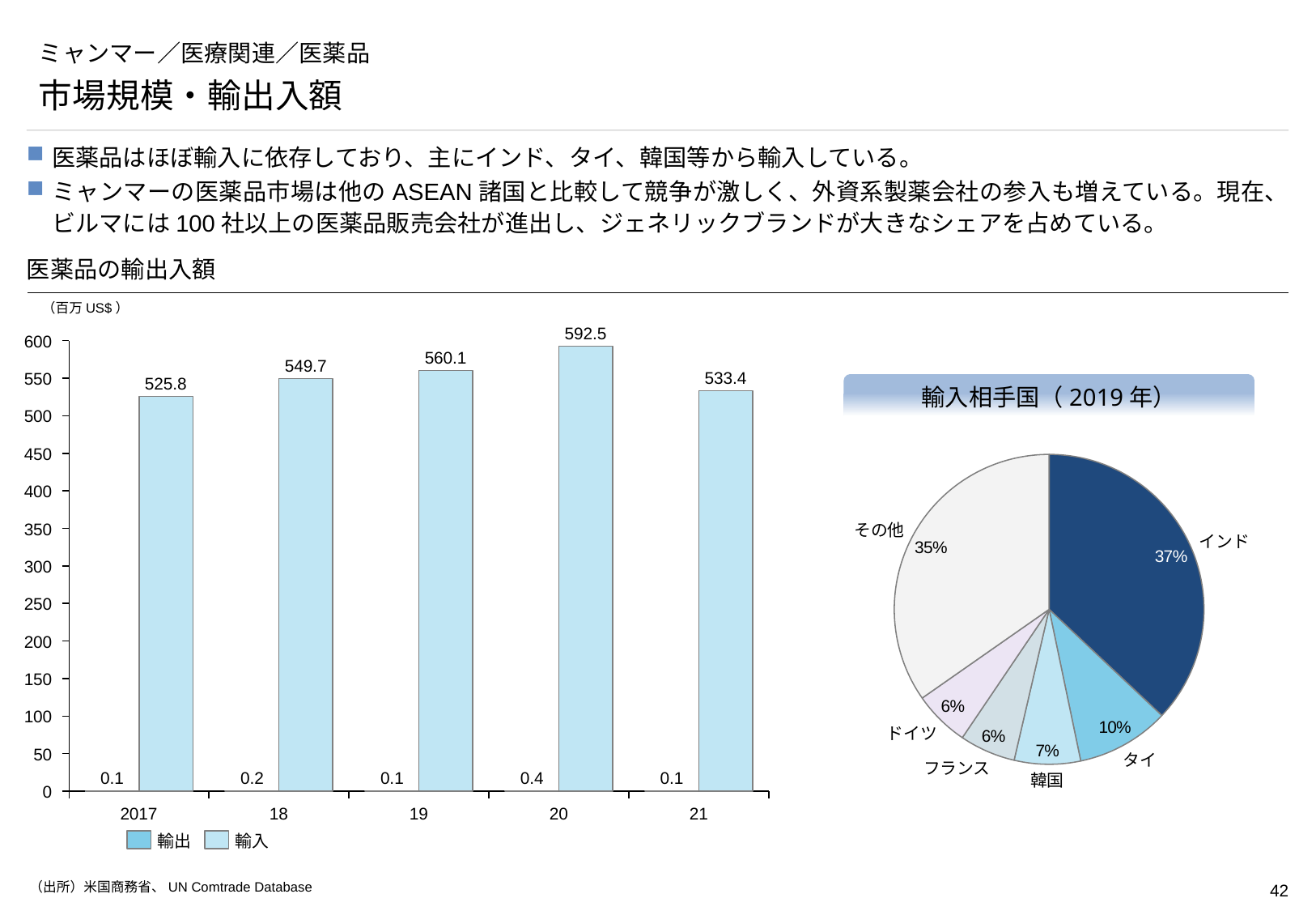
In the bar chart 医薬品の輸出入額, how many years are shown on the x axis? 5 In the bar chart 医薬品の輸出入額, is the 輸入 value for 2018 larger than the 輸入 value for 2019? No What kind of chart is 輸入相手国（2019年）? Pie chart In the bar chart 医薬品の輸出入額, which year has the highest 輸入 value? 2020 In the bar chart 医薬品の輸出入額, which year has the lowest 輸入 value? 2017 In the pie chart 輸入相手国（2019年）, what share does 韓国 have? 7% In the pie chart 輸入相手国（2019年）, which named country has the largest share? インド In the bar chart 医薬品の輸出入額, what is the difference between the 輸入 values for 2020 and 2021? 59.1 In the pie chart 輸入相手国（2019年）, what share does インド have? 37% In the bar chart 医薬品の輸出入額, what is the 輸出 value for 2020? 0.4 In the bar chart 医薬品の輸出入額, how many series does the legend list? 2 In the bar chart 医薬品の輸出入額, what is the 輸入 value for 2020? 592.5